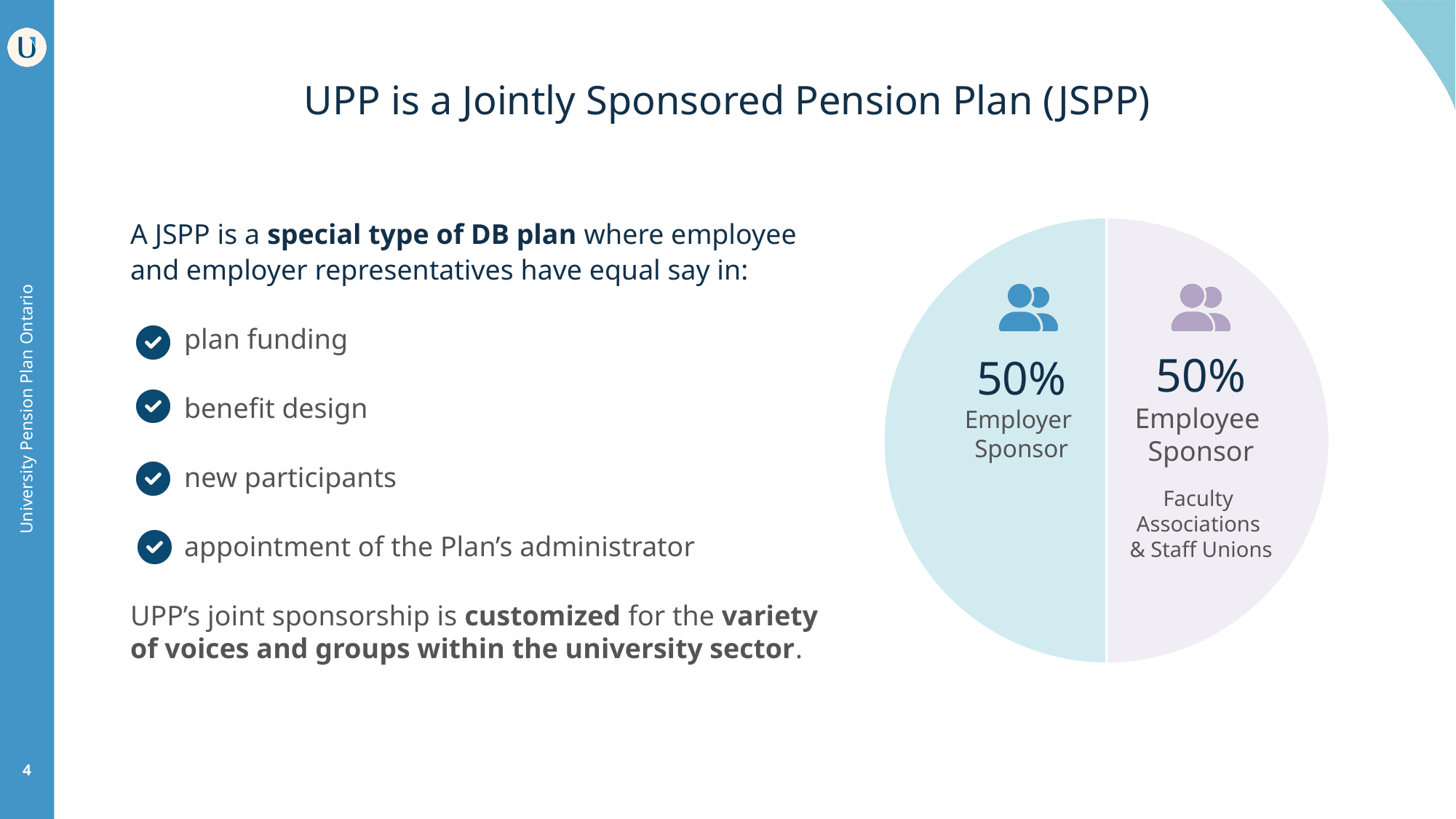
What share of the pie chart is labelled Employer Sponsor? 50% What is the difference between the Employer Sponsor share and the Employee Sponsor share? 0% What share of the pie chart is labelled Employee Sponsor? 50% Is the Employer Sponsor slice larger, smaller, or equal to the Employee Sponsor slice? equal Which groups are listed under the Employee Sponsor slice of the pie chart? Faculty Associations & Staff Unions What kind of chart is shown on the right side of the slide? pie chart Which slice of the pie chart is shown in light blue? Employer Sponsor How many slices does the pie chart have? 2 What is the combined share of the Employer Sponsor and Employee Sponsor slices? 100% Is the Employer Sponsor share greater or less than 25%? greater